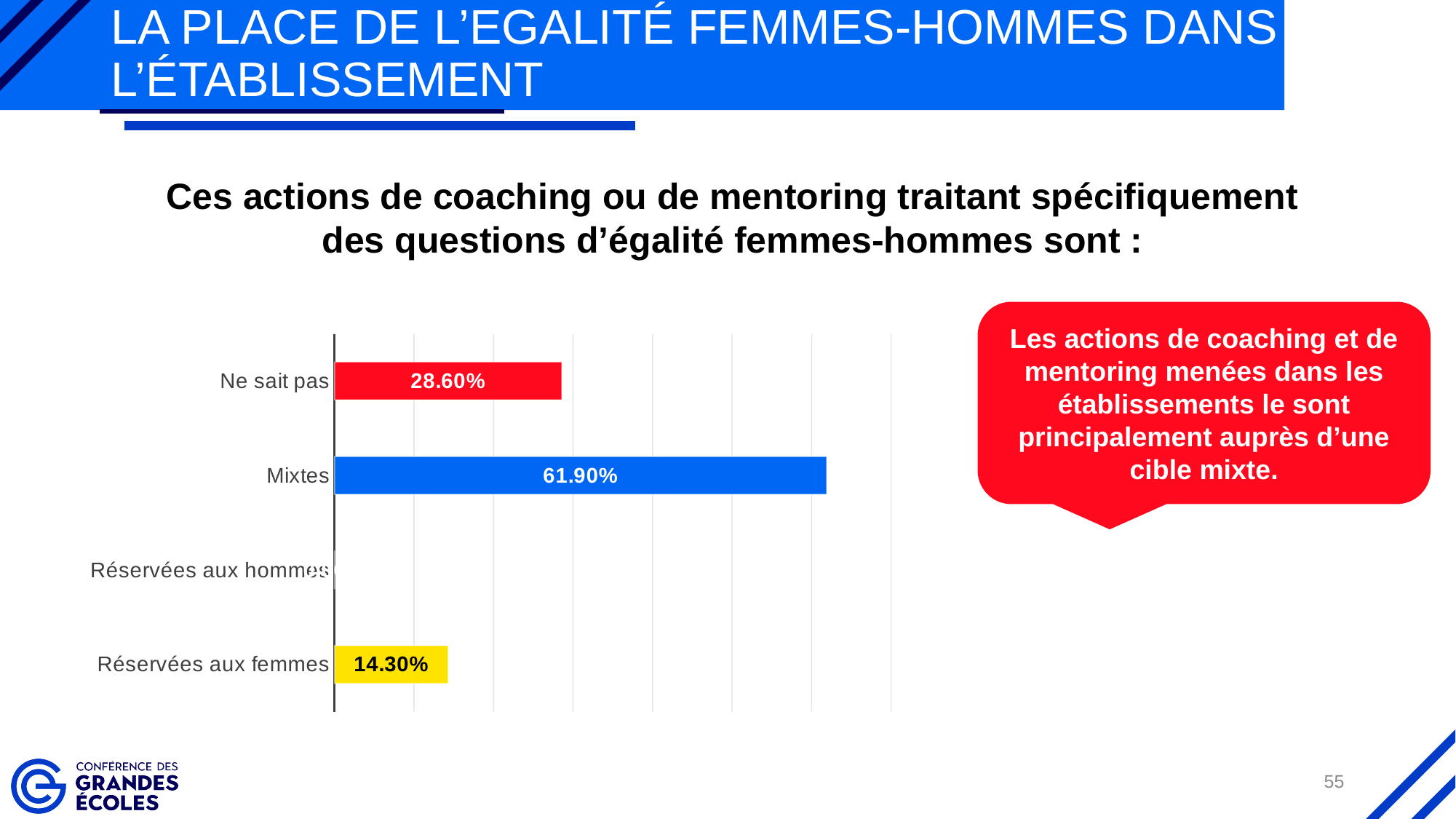
How many categories are shown in the chart? 4 What colour is the bar for Réservées aux femmes? Yellow What is the difference between the values for Mixtes and Ne sait pas? 33.30% What is the value for Ne sait pas? 28.60% What is the value for Mixtes? 61.90% What kind of chart is shown on the slide? Bar chart Which is larger, the value for Ne sait pas or the value for Réservées aux femmes? Ne sait pas Which category has the lowest value? Réservées aux hommes What is the difference between the values for Ne sait pas and Réservées aux femmes? 14.30% What is the value for Réservées aux femmes? 14.30% What colour is the bar for Mixtes? Blue Which category has the highest value? Mixtes